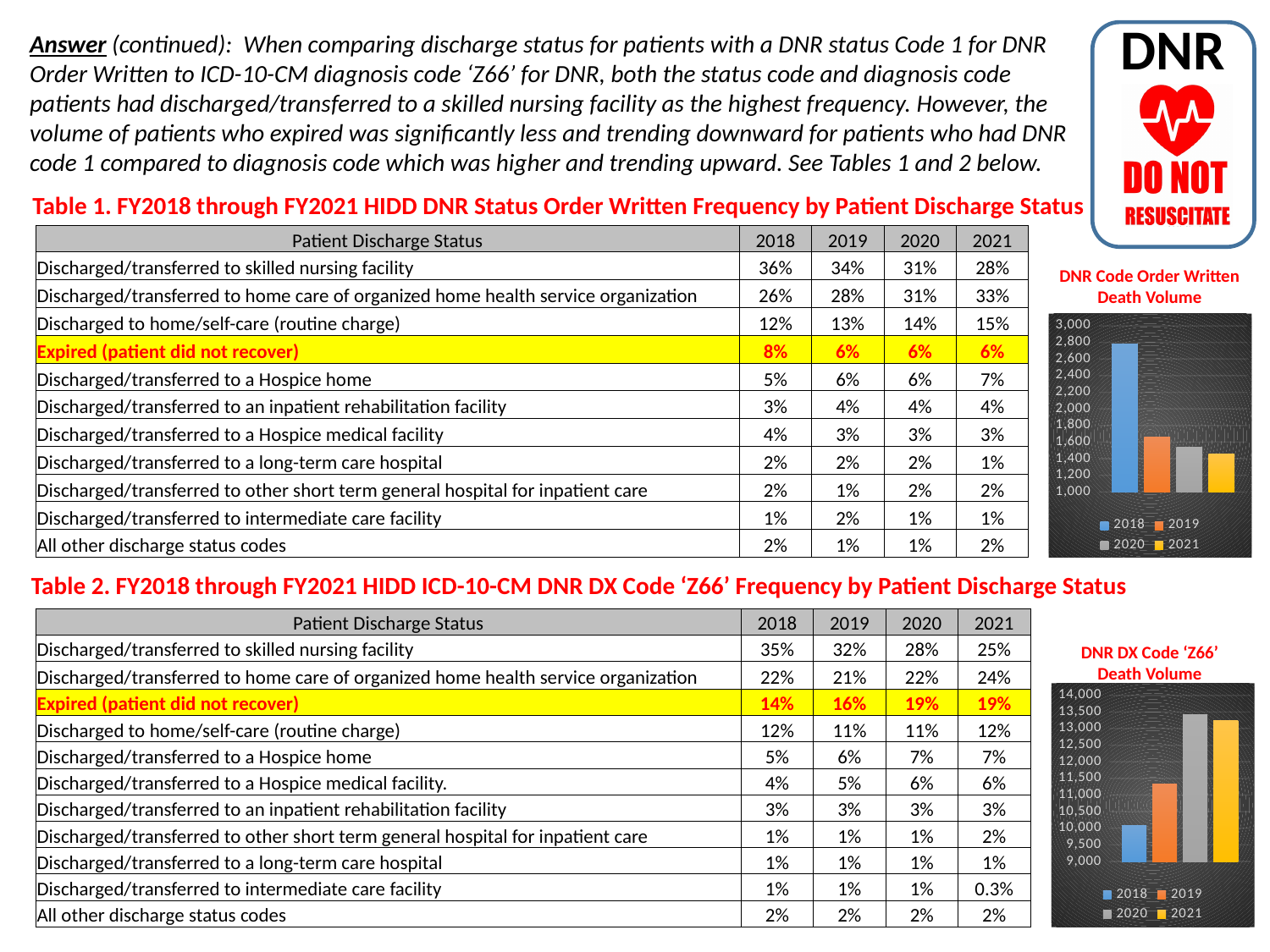
In the 'DNR DX Code Z66 Death Volume' chart, which year has the lowest bar? 2018 In the 'DNR Code Order Written Death Volume' chart, do the values rise or fall from 2018 to 2021? fall What kind of chart is the 'DNR Code Order Written Death Volume' chart? bar chart In the 'DNR DX Code Z66 Death Volume' chart, do the values generally rise or fall from 2018 to 2021? rise In the 'DNR Code Order Written Death Volume' chart, is the value for 2019 greater or less than 1,800? less In the 'DNR DX Code Z66 Death Volume' chart, is the value for 2020 greater or less than 13,000? greater How many entries does the legend of the 'DNR Code Order Written Death Volume' chart list? 4 What kind of chart is the 'DNR DX Code Z66 Death Volume' chart? bar chart In the 'DNR Code Order Written Death Volume' chart, is the value for 2018 greater or less than 2,600? greater In the 'DNR DX Code Z66 Death Volume' chart, which is larger, the value for 2018 or the value for 2020? 2020 In the 'DNR Code Order Written Death Volume' chart, which year has the highest bar? 2018 In the 'DNR Code Order Written Death Volume' chart, how many bars are plotted? 4